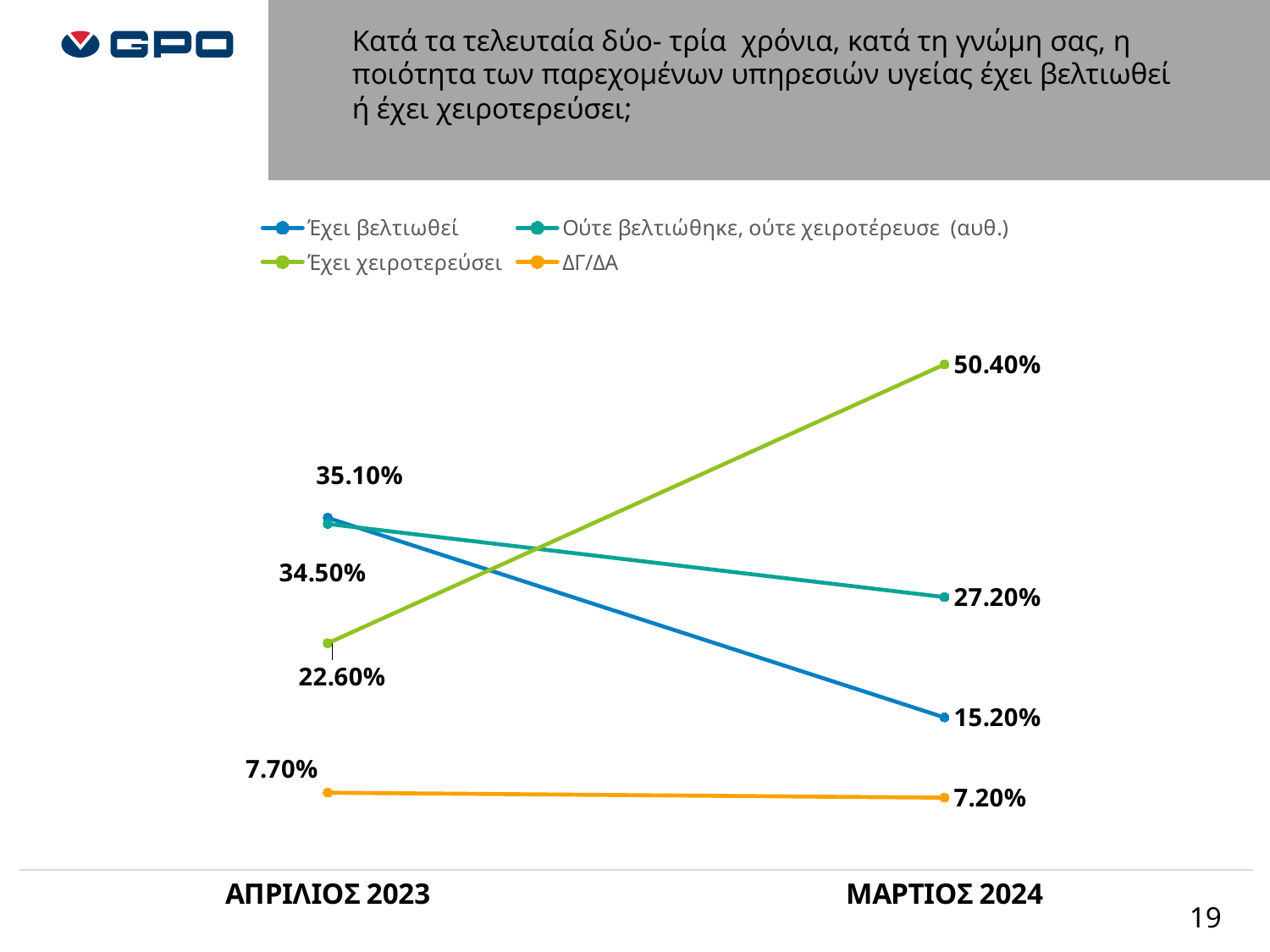
How many series does the legend list? 4 What is the value for Έχει χειροτερεύσει in ΜΑΡΤΙΟΣ 2024? 50.40% How many time points are shown on the x axis? 2 By how much did the value for Έχει χειροτερεύσει change from ΑΠΡΙΛΙΟΣ 2023 to ΜΑΡΤΙΟΣ 2024? 27.80% Does the value for Έχει βελτιωθεί rise or fall from ΑΠΡΙΛΙΟΣ 2023 to ΜΑΡΤΙΟΣ 2024? fall What is the value for Έχει βελτιωθεί in ΑΠΡΙΛΙΟΣ 2023? 35.10% What is the value for Ούτε βελτιώθηκε, ούτε χειροτέρευσε (αυθ.) in ΜΑΡΤΙΟΣ 2024? 27.20% What is the value for ΔΓ/ΔΑ in ΜΑΡΤΙΟΣ 2024? 7.20% Which series has the highest value in ΜΑΡΤΙΟΣ 2024? Έχει χειροτερεύσει Which is larger in ΜΑΡΤΙΟΣ 2024: Έχει βελτιωθεί or Ούτε βελτιώθηκε, ούτε χειροτέρευσε (αυθ.)? Ούτε βελτιώθηκε, ούτε χειροτέρευσε (αυθ.) What type of chart is shown on the slide? line chart Which series has the lowest value in ΑΠΡΙΛΙΟΣ 2023? ΔΓ/ΔΑ